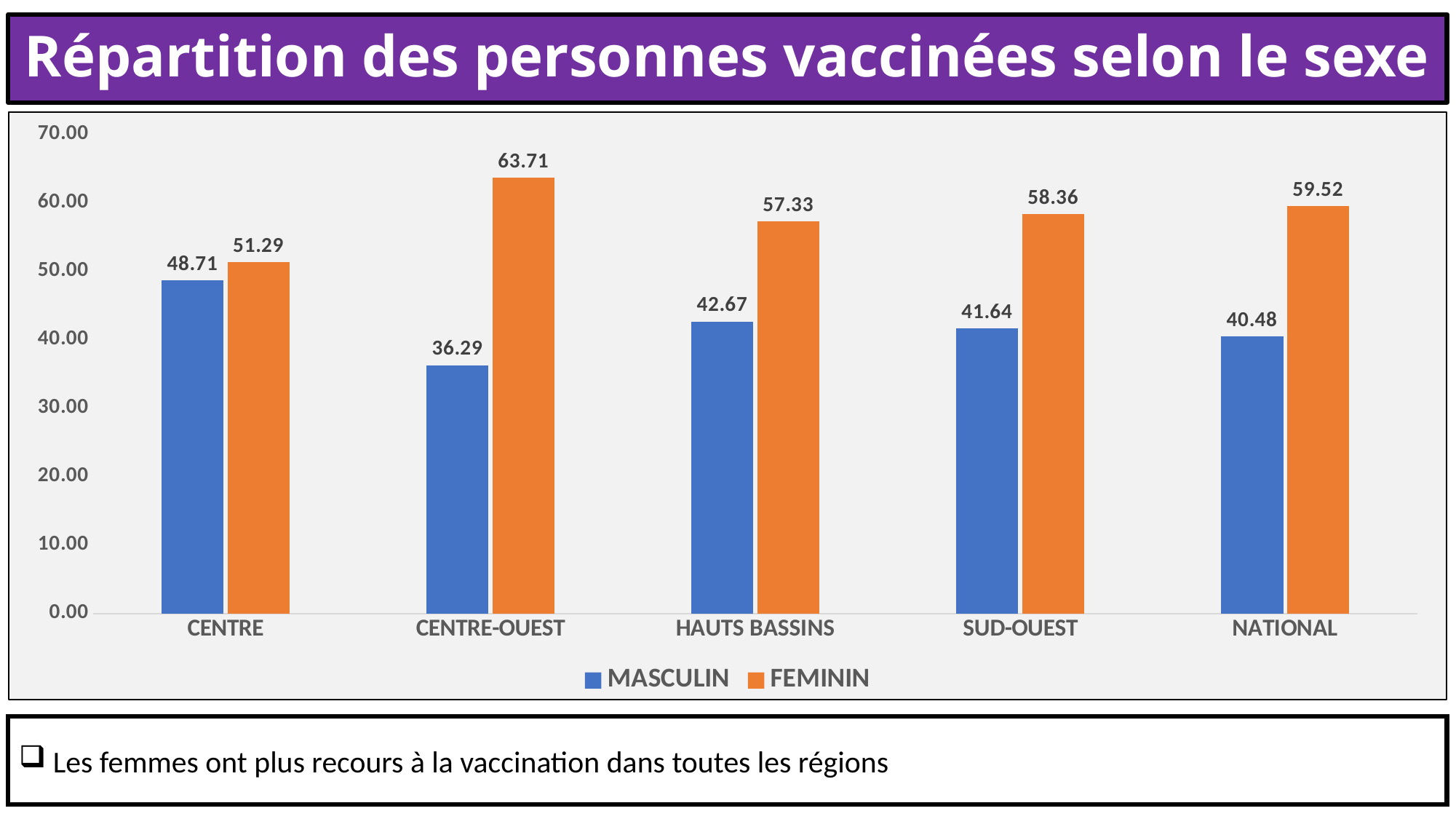
What is the FEMININ value for NATIONAL? 59.52 What is the MASCULIN value for CENTRE-OUEST? 36.29 Is the MASCULIN value for HAUTS BASSINS greater or less than 40.00? greater How many series does the legend list? 2 Which category has the highest FEMININ value? CENTRE-OUEST Which is larger for CENTRE: the MASCULIN value or the FEMININ value? FEMININ How many categories are shown on the x axis? 5 Which category has the lowest MASCULIN value? CENTRE-OUEST Which colour represents the FEMININ series? Orange What kind of chart is shown on the slide? Bar chart What is the FEMININ value for HAUTS BASSINS? 57.33 What is the difference between the FEMININ and MASCULIN values for SUD-OUEST? 16.72